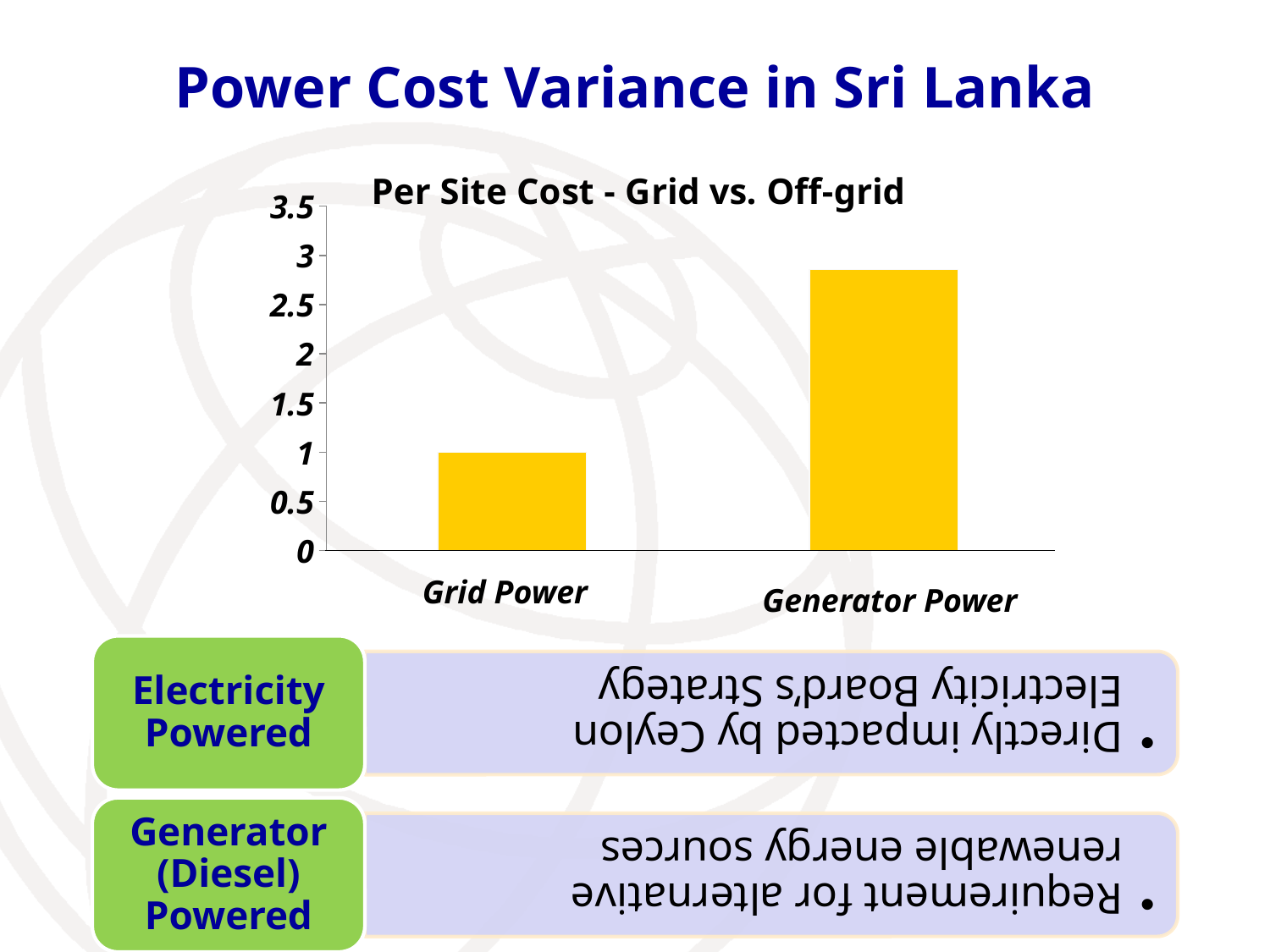
What kind of chart is shown on the slide? bar chart Is the value for Generator Power greater or less than 3? less What is the title of the chart? Per Site Cost - Grid vs. Off-grid What is the value for Grid Power? 1 What is the highest value shown on the vertical axis? 3.5 Which is larger, the value for Grid Power or the value for Generator Power? Generator Power How many categories are plotted in the chart? 2 Which category has the lowest value? Grid Power Which category has the highest value? Generator Power Is the value for Grid Power greater or less than 1.5? less Do the values rise or fall from Grid Power to Generator Power? rise Is the value for Generator Power greater or less than 2.5? greater